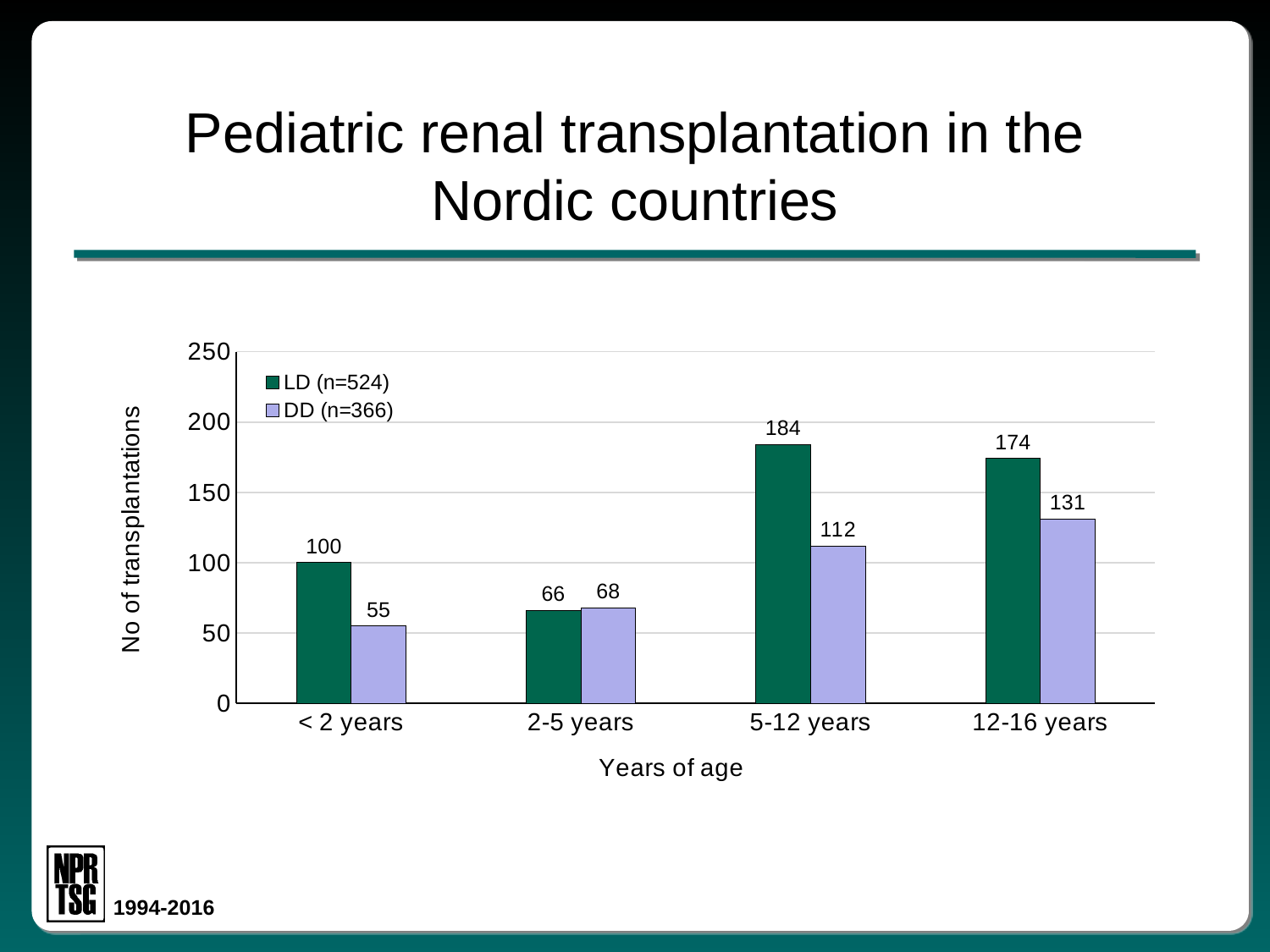
In the 2-5 years age group, which is larger: LD or DD transplantations? DD What is the label of the y axis? No of transplantations How many series does the legend list? 2 How many age groups are shown on the x axis? 4 Which age group has the highest number of LD transplantations? 5-12 years What is the difference between LD and DD transplantations in the 12-16 years age group? 43 What kind of chart is shown on the slide? bar chart What is the number of DD transplantations for the 12-16 years age group? 131 What is the number of DD transplantations for the < 2 years age group? 55 Is the number of DD transplantations for 5-12 years greater or less than 100? greater What is the number of LD transplantations for the 5-12 years age group? 184 Which age group has the lowest number of DD transplantations? < 2 years